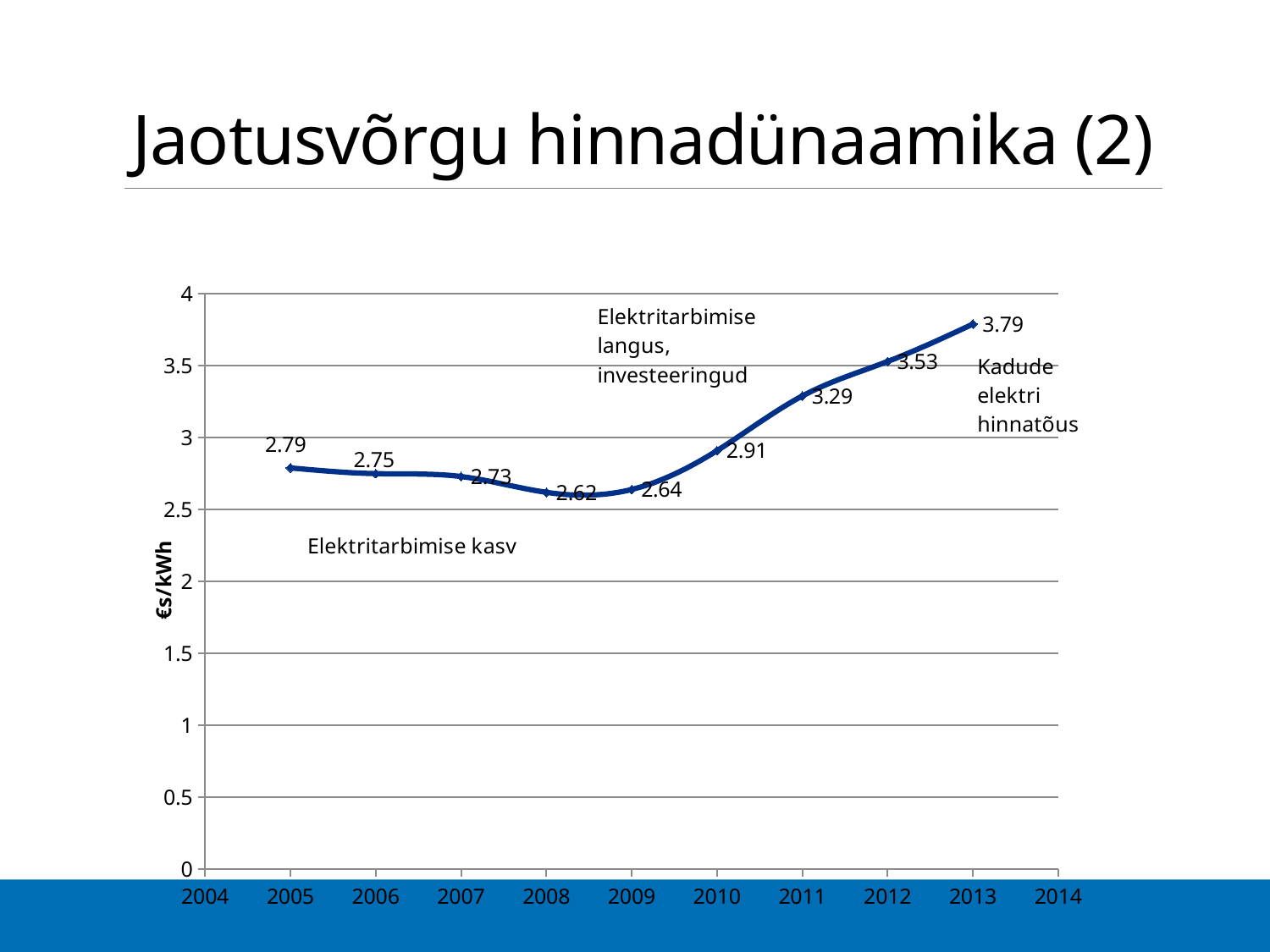
What is the label of the vertical axis? €s/kWh Which year has the highest value? 2013 What is the value for 2008? 2.62 What is the value for 2011? 3.29 Which year has the lowest value? 2008 What is the difference between the values for 2012 and 2011? 0.24 What is the value for 2005? 2.79 What is the value for 2013? 3.79 Which is larger, the value for 2010 or the value for 2009? 2010 What type of chart is shown on the slide? line chart How many data points are plotted on the line? 9 What is the difference between the values for 2013 and 2005? 1.00